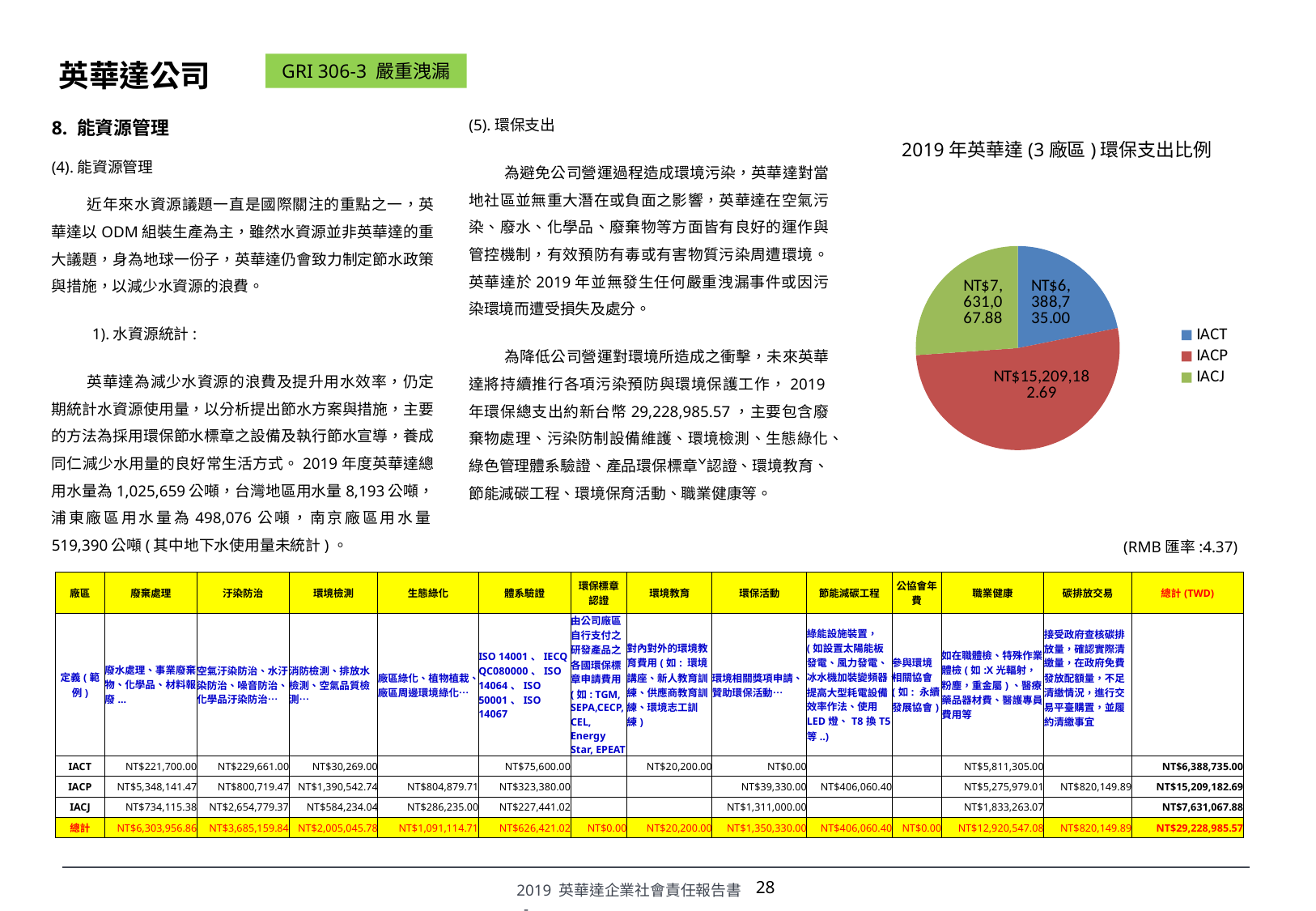
How many slices does the pie chart have? 3 Which plant has the largest slice in the pie chart? IACP How many entries does the pie chart legend list? 3 What is the value shown for IACT in the pie chart? NT$6,388,735.00 Which colour represents IACP in the pie chart? Red What is the value shown for IACJ in the pie chart? NT$7,631,067.88 What type of chart is shown on the slide? Pie chart What is the value shown for IACP in the pie chart? NT$15,209,182.69 What is the difference between the IACP and IACT values in the pie chart? NT$8,820,447.69 What is the difference between the IACJ and IACT values in the pie chart? NT$1,242,332.88 Which plant has the smallest slice in the pie chart? IACT Which is larger in the pie chart, IACJ or IACT? IACJ